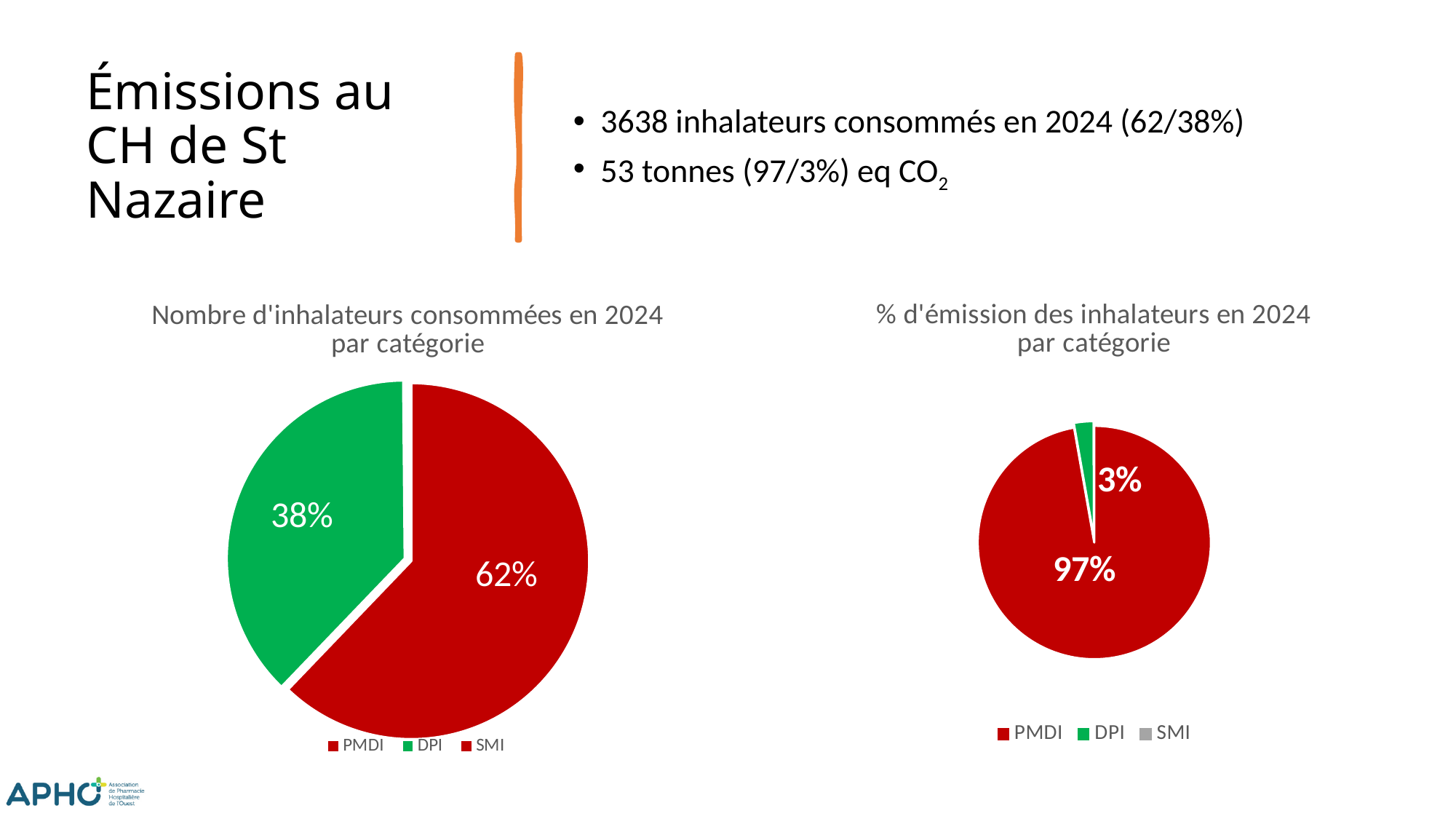
In the right chart, what is the difference in percentage points between the PMDI and DPI slices? 94 In the chart titled "Nombre d'inhalateurs consommées en 2024 par catégorie", what share of the pie does PMDI have? 62% What type of chart is the chart titled "% d'émission des inhalateurs en 2024 par catégorie"? Pie chart In the left chart, what is the difference in percentage points between the PMDI and DPI slices? 24 How many entries does the legend of the left chart list? 3 In the right chart, which labelled category has the smallest slice? DPI In the right chart, which is larger, the PMDI slice or the DPI slice? PMDI What colour is the PMDI slice in the right chart? Red In the chart titled "% d'émission des inhalateurs en 2024 par catégorie", what share of the pie does DPI have? 3% In the left chart, which category has the largest slice? PMDI In the chart titled "Nombre d'inhalateurs consommées en 2024 par catégorie", what share of the pie does DPI have? 38% In the chart titled "% d'émission des inhalateurs en 2024 par catégorie", what share of the pie does PMDI have? 97%